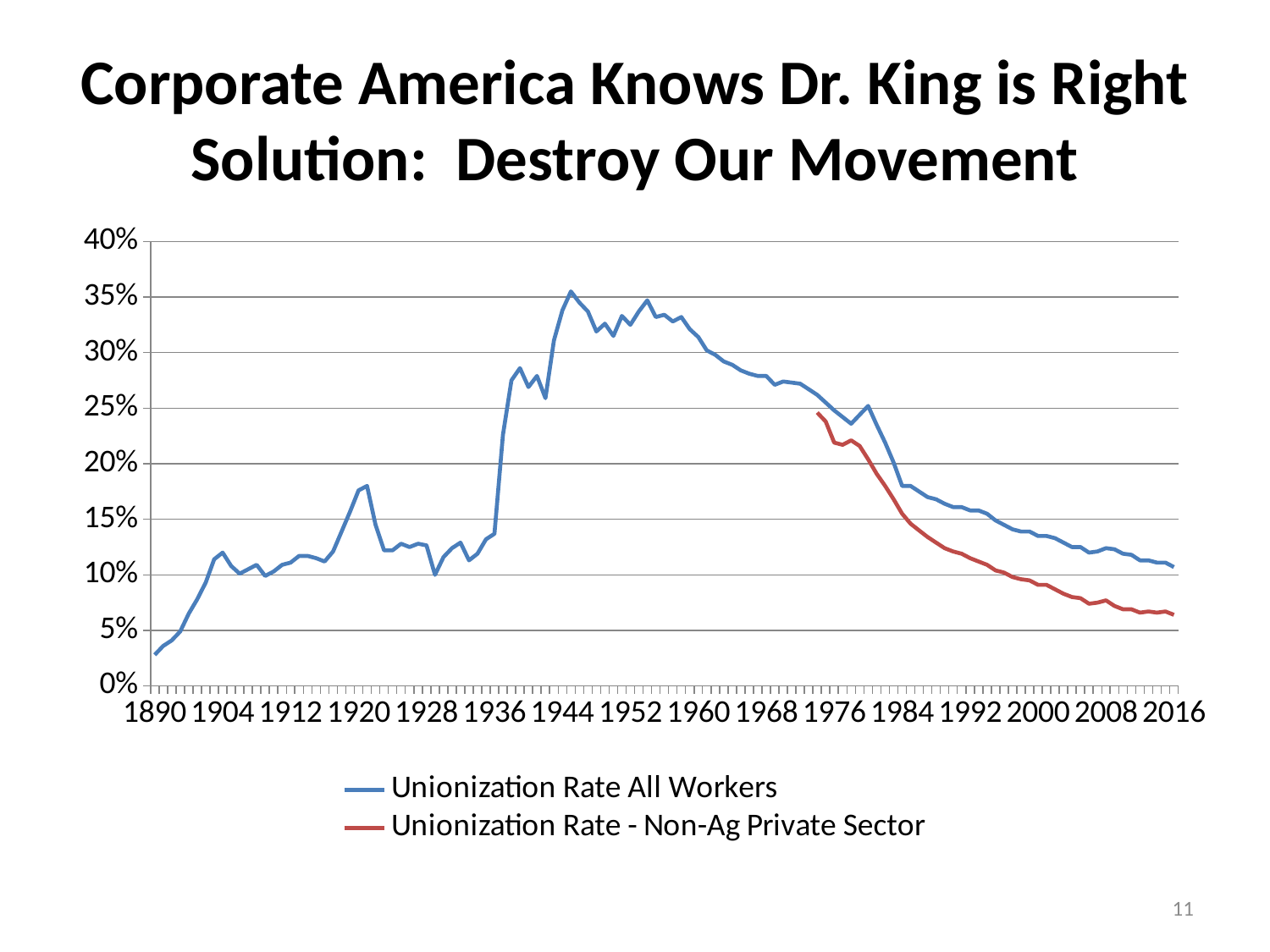
What are the two series named in the legend? Unionization Rate All Workers; Unionization Rate - Non-Ag Private Sector What colour is the line for Unionization Rate All Workers? blue In 2016, which series has the higher value, Unionization Rate All Workers or Unionization Rate - Non-Ag Private Sector? Unionization Rate All Workers What kind of chart is shown on the slide? line chart Is the peak value of Unionization Rate All Workers around 1944 greater or less than 30%? greater Is the value for Unionization Rate - Non-Ag Private Sector in 1984 greater or less than 20%? less From 1984 to 2016, does the Unionization Rate All Workers line rise or fall? fall Is the value for Unionization Rate - Non-Ag Private Sector in 2016 greater or less than 10%? less From 1890 to 1904, does the Unionization Rate All Workers line rise or fall? rise How many series does the legend list? 2